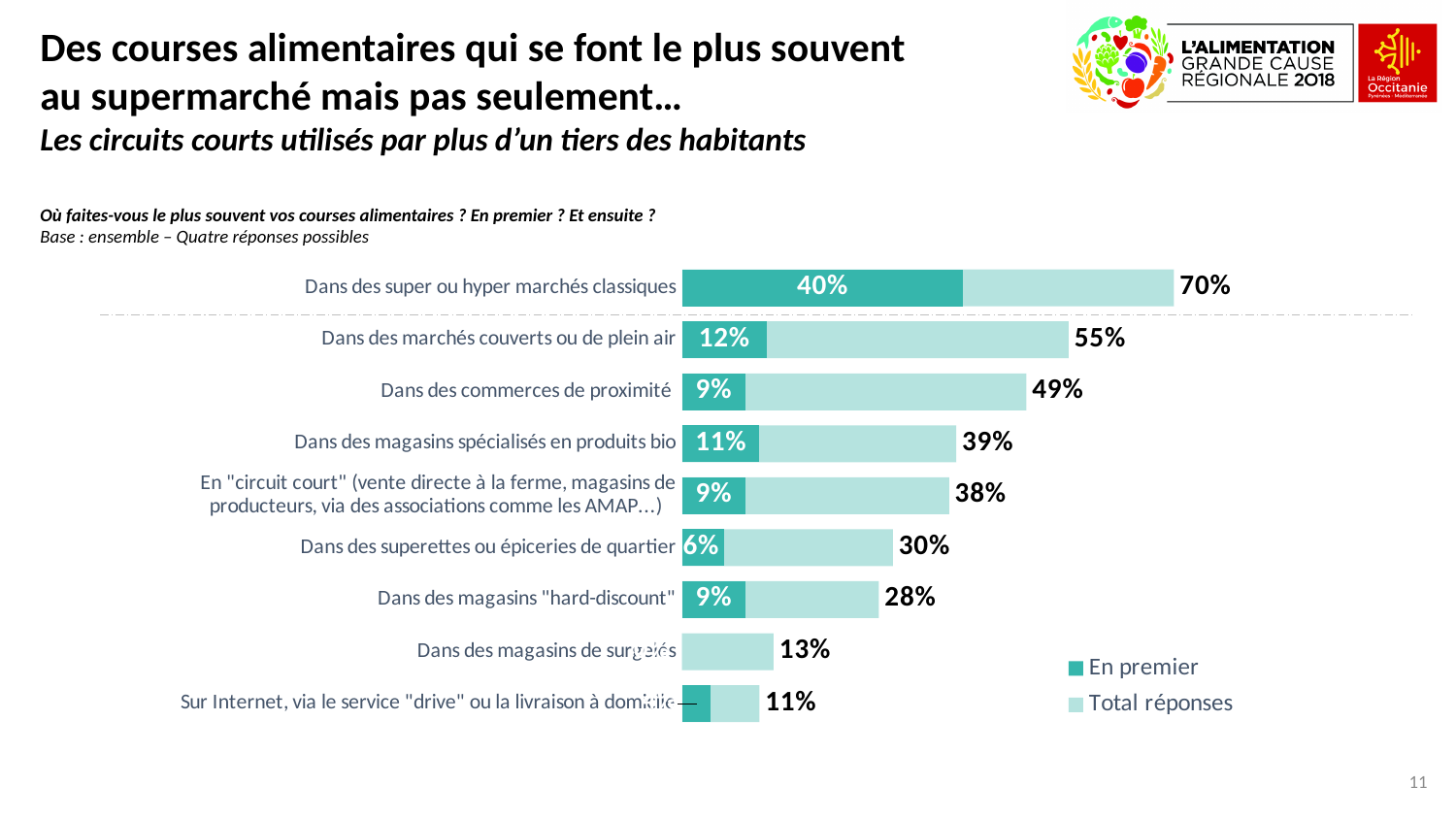
What is the difference in "Total réponses" between "Dans des super ou hyper marchés classiques" and "Dans des marchés couverts ou de plein air"? 15 percentage points How many series does the legend list? 2 Which has a higher "Total réponses" value: "Dans des magasins spécialisés en produits bio" or "Dans des magasins "hard-discount""? Dans des magasins spécialisés en produits bio What is the "Total réponses" value for "Dans des commerces de proximité"? 49% Which category has the lowest "Total réponses" value? Sur Internet, via le service "drive" ou la livraison à domicile Which category has the highest "Total réponses" value? Dans des super ou hyper marchés classiques What is the "En premier" value for "Dans des marchés couverts ou de plein air"? 12% What kind of chart is shown on the slide? Bar chart What is the "En premier" value for "Dans des superettes ou épiceries de quartier"? 6% How many categories are shown in the chart? 9 What is the "En premier" value for "Dans des super ou hyper marchés classiques"? 40% What is the "Total réponses" value for "Dans des super ou hyper marchés classiques"? 70%